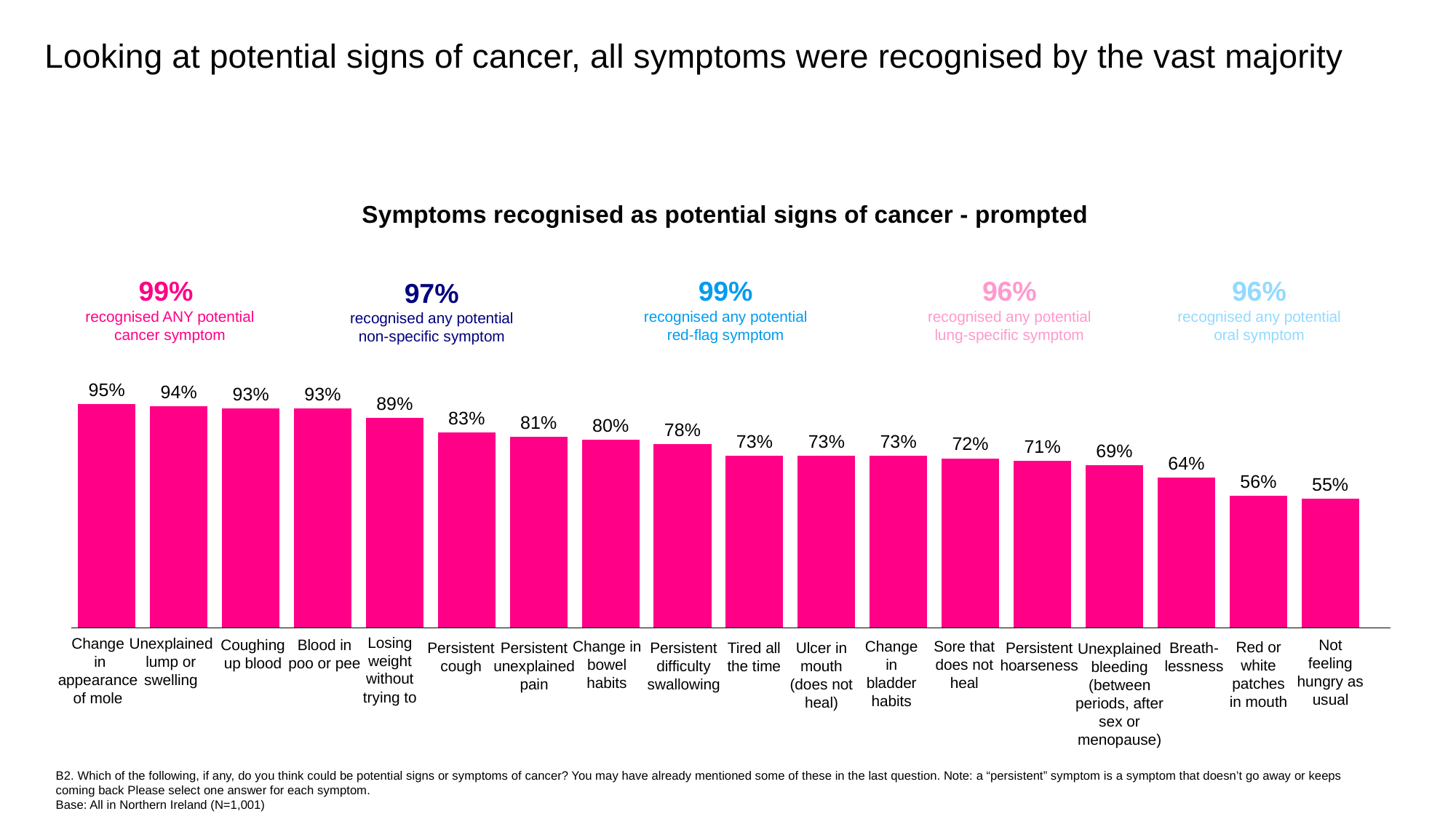
What is the title of the chart? Symptoms recognised as potential signs of cancer - prompted What type of chart is used on this slide? Bar chart Which symptom has the lowest recognition percentage? Not feeling hungry as usual Which symptom has the highest recognition percentage? Change in appearance of mole Which is larger: the value for 'Change in bowel habits' or 'Persistent difficulty swallowing'? Change in bowel habits What is the difference between 'Losing weight without trying to' and 'Persistent cough'? 6 percentage points What is the value for 'Unexplained bleeding (between periods, after sex or menopause)'? 69% What is the difference between the values for 'Change in appearance of mole' and 'Not feeling hungry as usual'? 40 percentage points What percentage recognised 'Change in appearance of mole' as a potential sign of cancer? 95% What percentage is shown for 'Breathlessness'? 64% What is the value shown for 'Persistent cough'? 83% How many symptoms (bars) are shown in the chart? 18